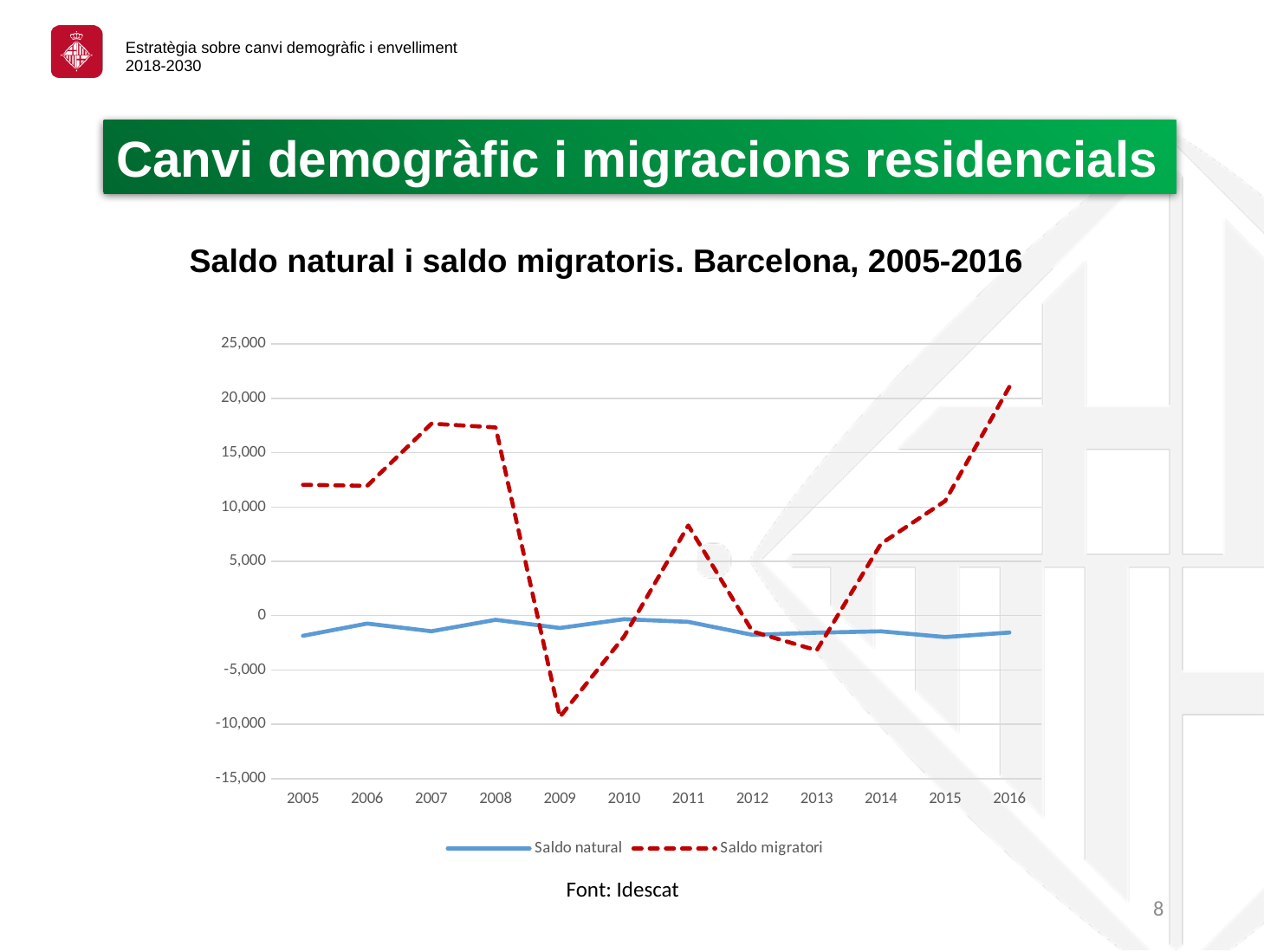
In which year does the Saldo migratori series reach its highest value? 2016 Which series is drawn with a red dashed line? Saldo migratori In which year does the Saldo migratori series reach its lowest value? 2009 Which is larger, the Saldo migratori value for 2007 or for 2011? 2007 How many years are plotted along the x axis? 12 Does the Saldo migratori series rise or fall from 2013 to 2016? rise How many series does the legend list? 2 Is the Saldo migratori value for 2005 greater or less than 10,000? greater Is the Saldo natural value for 2005 greater or less than 0? less Is the Saldo migratori value for 2007 greater or less than 15,000? greater What kind of chart is shown on the slide? line chart